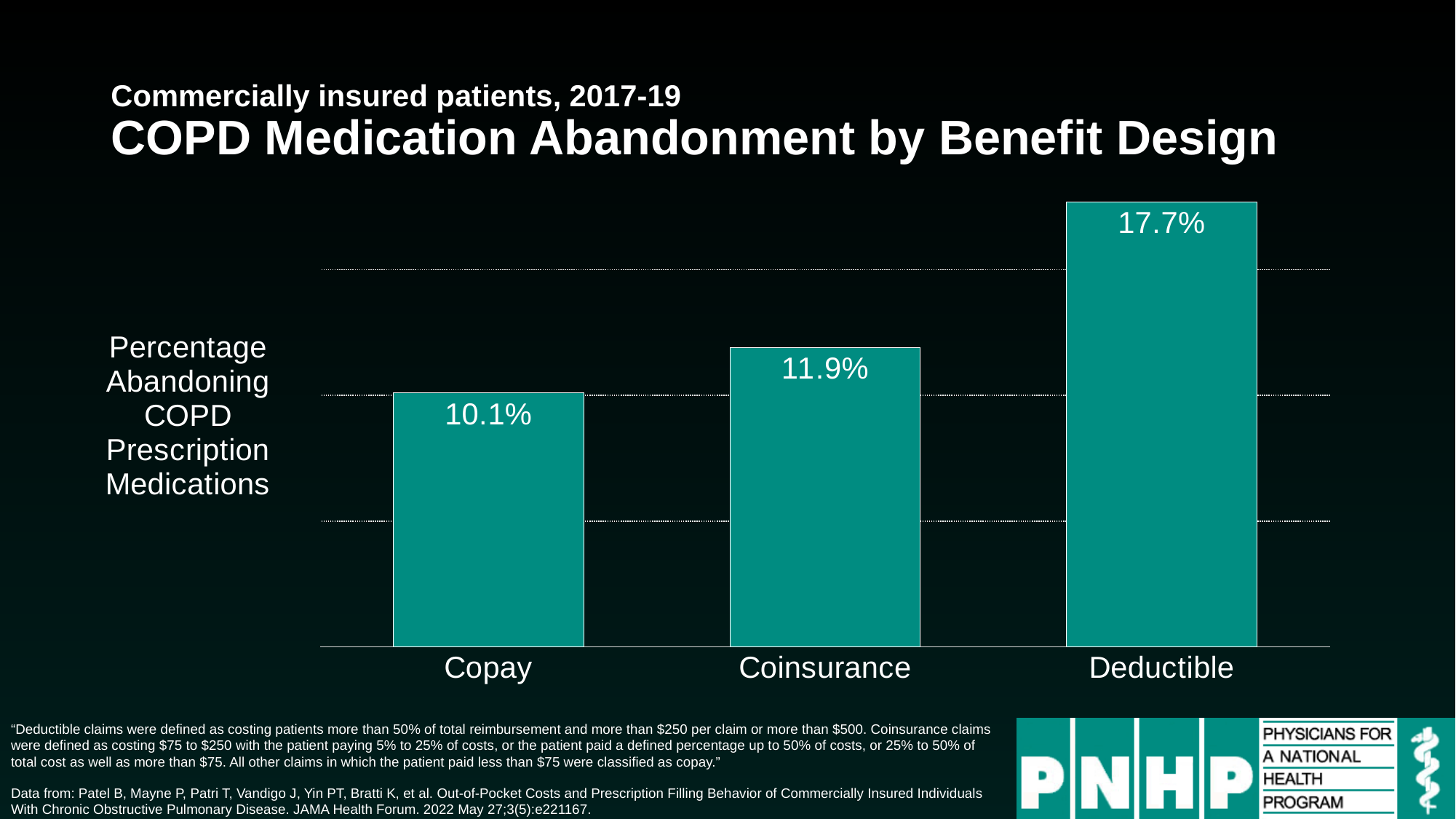
What percentage of commercially insured patients abandoned COPD prescription medications under the Copay benefit design? 10.1% What is the difference in abandonment percentage between Coinsurance and Copay? 1.8 percentage points Which benefit design has the lowest percentage abandoning COPD prescription medications? Copay What is the difference in abandonment percentage between the Deductible and Copay benefit designs? 7.6 percentage points How many benefit design categories are shown in the chart? 3 Which benefit design has the highest percentage abandoning COPD prescription medications? Deductible Which has a higher abandonment percentage, Coinsurance or Deductible? Deductible What is the abandonment percentage for the Coinsurance benefit design? 11.9% What is the abandonment percentage for the Deductible benefit design? 17.7% What type of chart is used on this slide? Bar chart Do the abandonment percentages rise or fall moving from Copay to Deductible along the x axis? Rise What is the title of the chart on this slide? COPD Medication Abandonment by Benefit Design